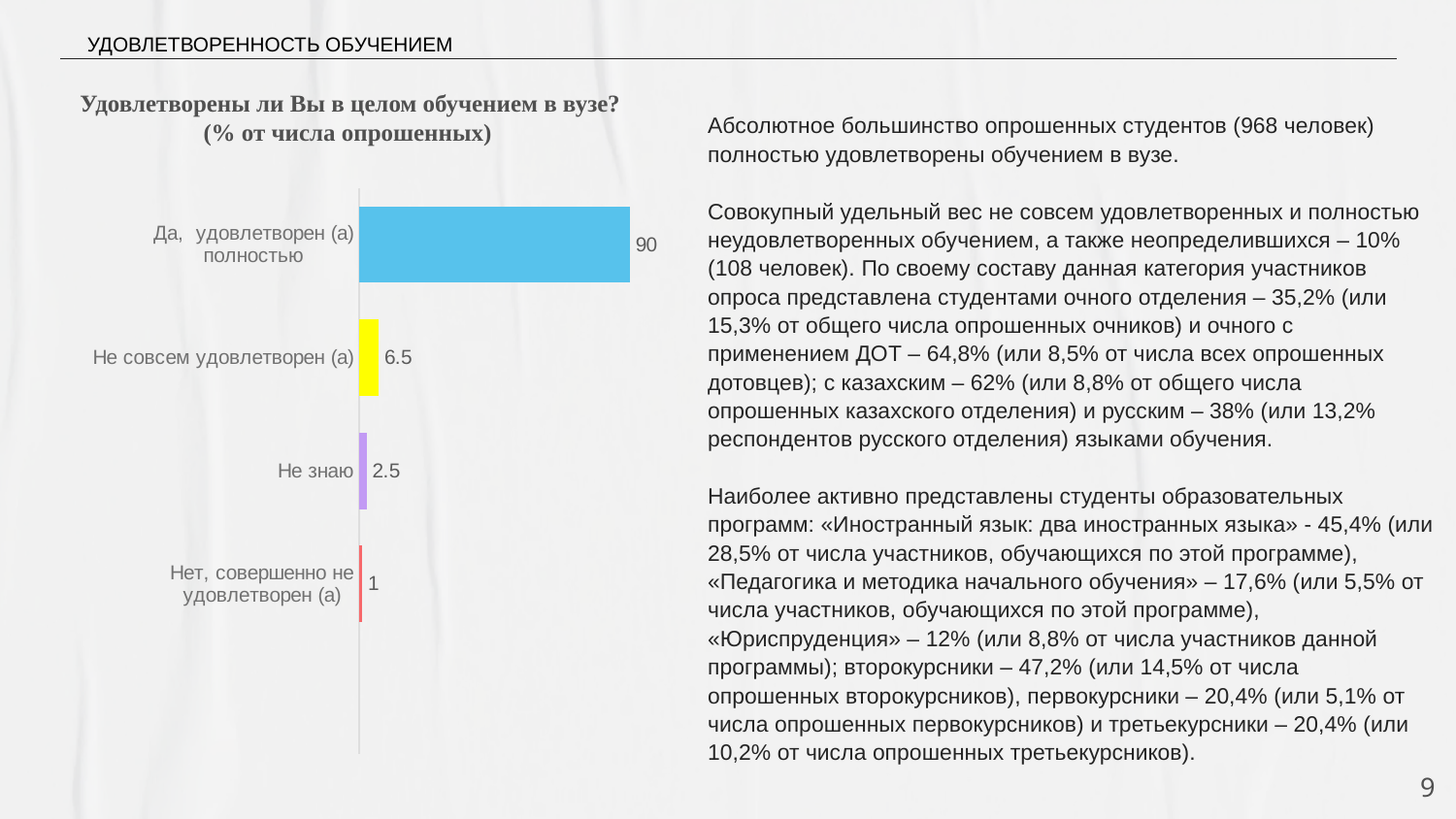
How many categories are shown in the chart? 4 What is the value for "Не совсем удовлетворен (а)"? 6.5 What is the value for "Нет, совершенно не удовлетворен (а)"? 1 What is the value for "Да, удовлетворен (а) полностью"? 90 Which is larger, the value for "Не знаю" or the value for "Нет, совершенно не удовлетворен (а)"? Не знаю Which category has the lowest value? Нет, совершенно не удовлетворен (а) What is the difference between the values for "Не совсем удовлетворен (а)" and "Не знаю"? 4 What is the difference between the values for "Да, удовлетворен (а) полностью" and "Не совсем удовлетворен (а)"? 83.5 Which category has the highest value? Да, удовлетворен (а) полностью What is the title of the chart? Удовлетворены ли Вы в целом обучением в вузе? (% от числа опрошенных) What type of chart is shown on the slide? bar chart What is the value for "Не знаю"? 2.5